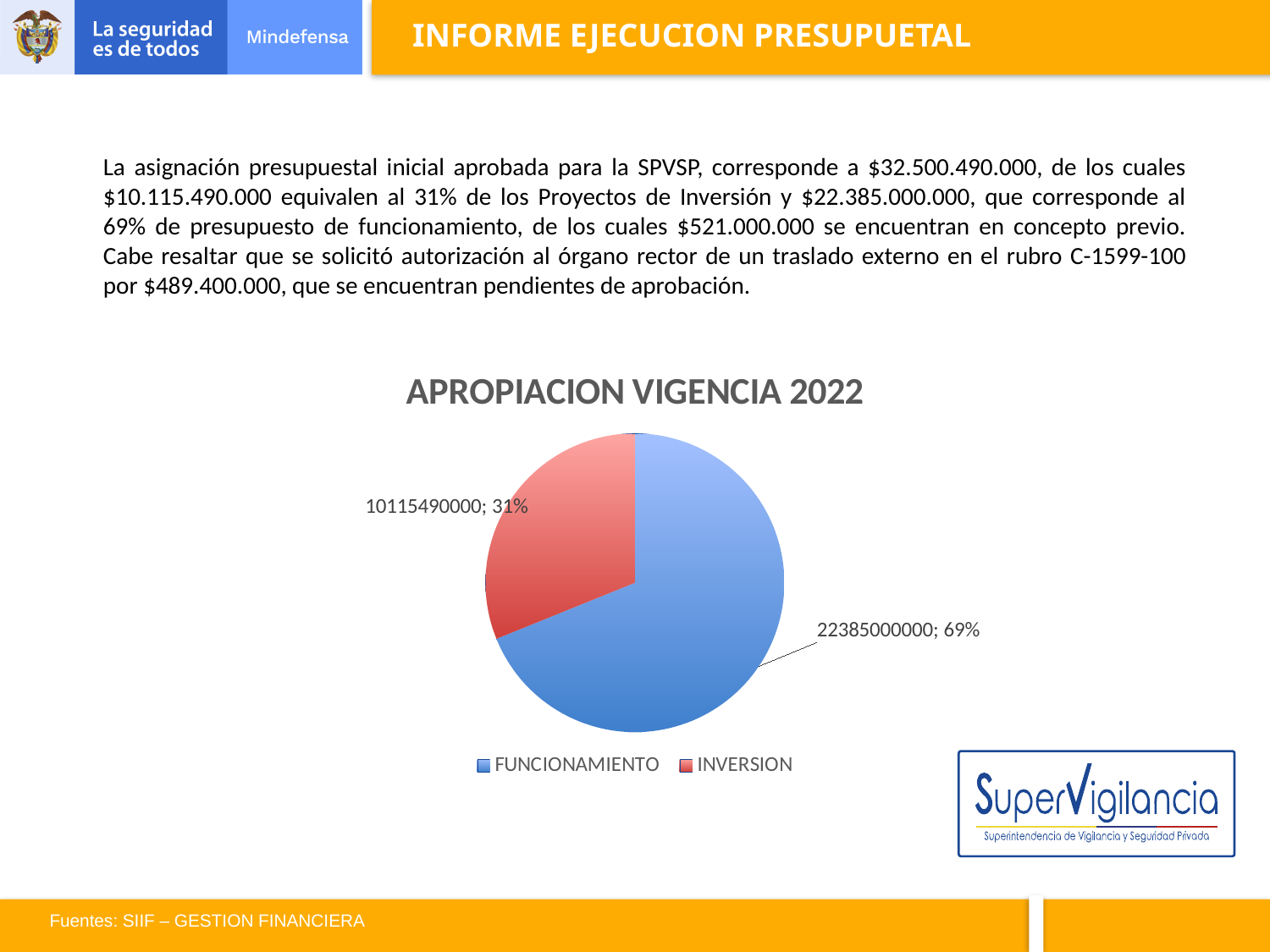
What share of the pie does FUNCIONAMIENTO represent? 69% What share of the pie does INVERSION represent? 31% What is the difference between the FUNCIONAMIENTO and INVERSION values? 12269510000 How many categories does the pie chart show? 2 What kind of chart is shown on the slide? Pie chart Which is larger, FUNCIONAMIENTO or INVERSION? FUNCIONAMIENTO Which category has the smallest slice in the pie chart? INVERSION What colour is the INVERSION slice in the pie chart? Red What is the value for FUNCIONAMIENTO in the pie chart? 22385000000 What is the value for INVERSION in the pie chart? 10115490000 Which category has the largest slice in the pie chart? FUNCIONAMIENTO What is the title of the chart? APROPIACION VIGENCIA 2022